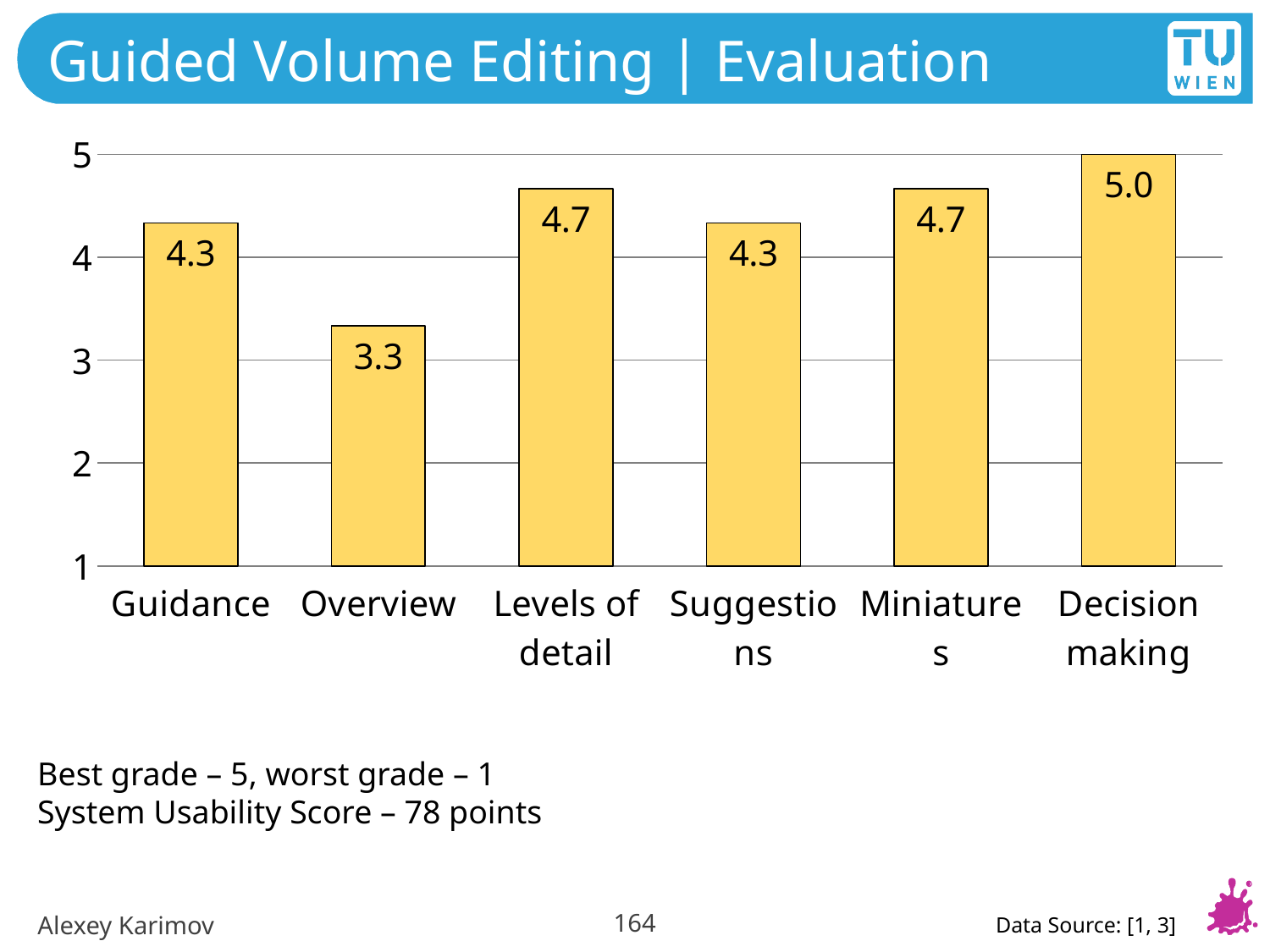
Which is larger, the value for Miniatures or the value for Suggestions? Miniatures How many categories are shown in the chart? 6 Which category has the lowest value? Overview What kind of chart is shown on the slide? bar chart Is the value for Overview greater or less than 4? less What is the difference between the values for Levels of detail and Guidance? 0.4 What is the value for Guidance? 4.3 What is the value for Overview? 3.3 What is the value for Decision making? 5.0 Which category has the highest value? Decision making What is the difference between the values for Decision making and Overview? 1.7 What is the value for Levels of detail? 4.7